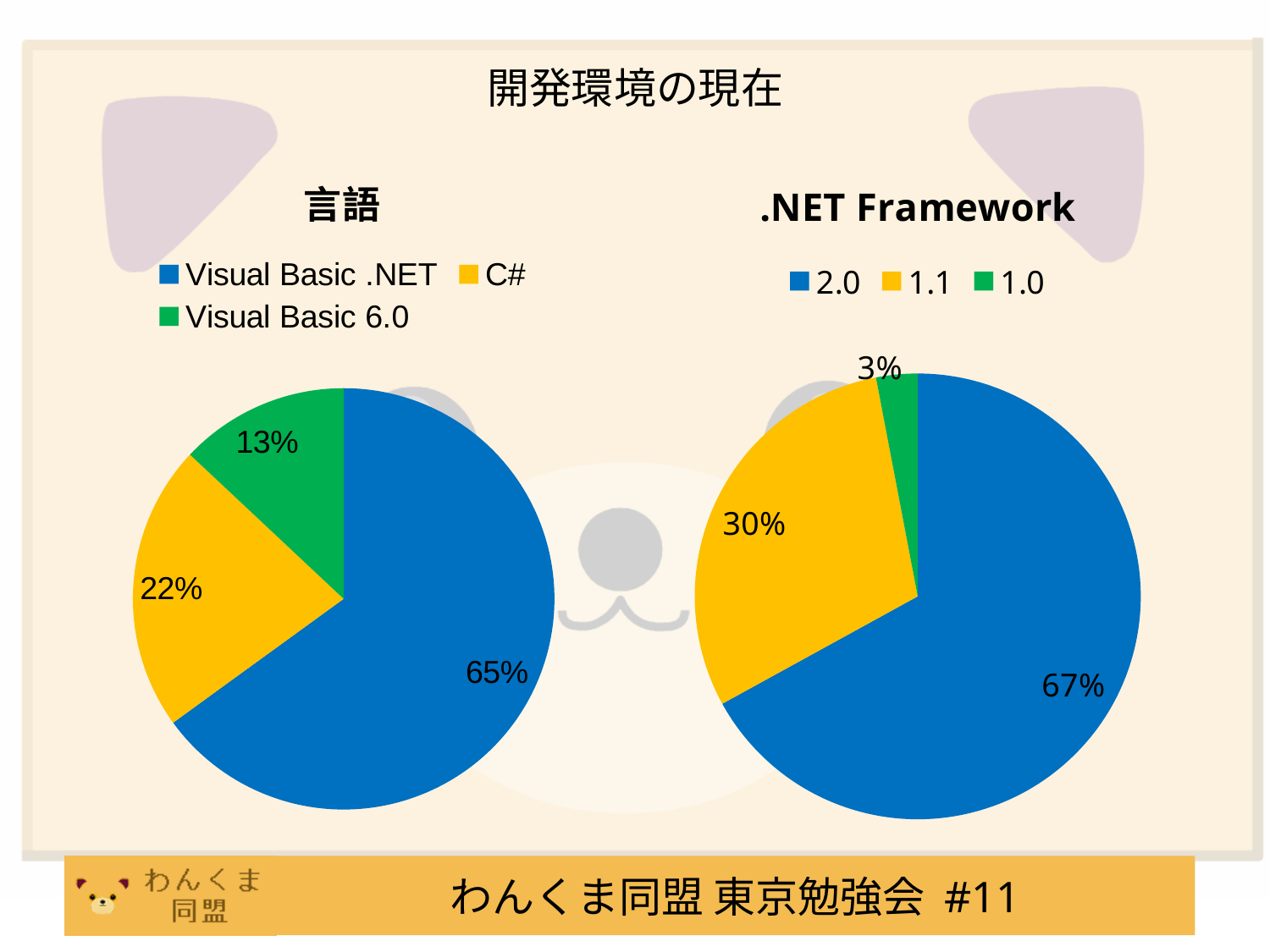
How many categories does the legend of the .NET Framework chart list? 3 In the .NET Framework chart, what share does 2.0 have? 67% In the .NET Framework chart, which category has the largest share? 2.0 In the 言語 chart, which category has the smallest share? Visual Basic 6.0 What kind of chart is the 言語 chart? Pie chart In the .NET Framework chart, what share does 1.1 have? 30% In the 言語 chart, what is the difference between the shares of Visual Basic .NET and C#? 43% In the 言語 chart, what share does C# have? 22% In the .NET Framework chart, what is the difference between the shares of 1.1 and 1.0? 27% In the 言語 chart, what share does Visual Basic 6.0 have? 13% In the .NET Framework chart, what share does 1.0 have? 3% In the 言語 chart, what share does Visual Basic .NET have? 65%